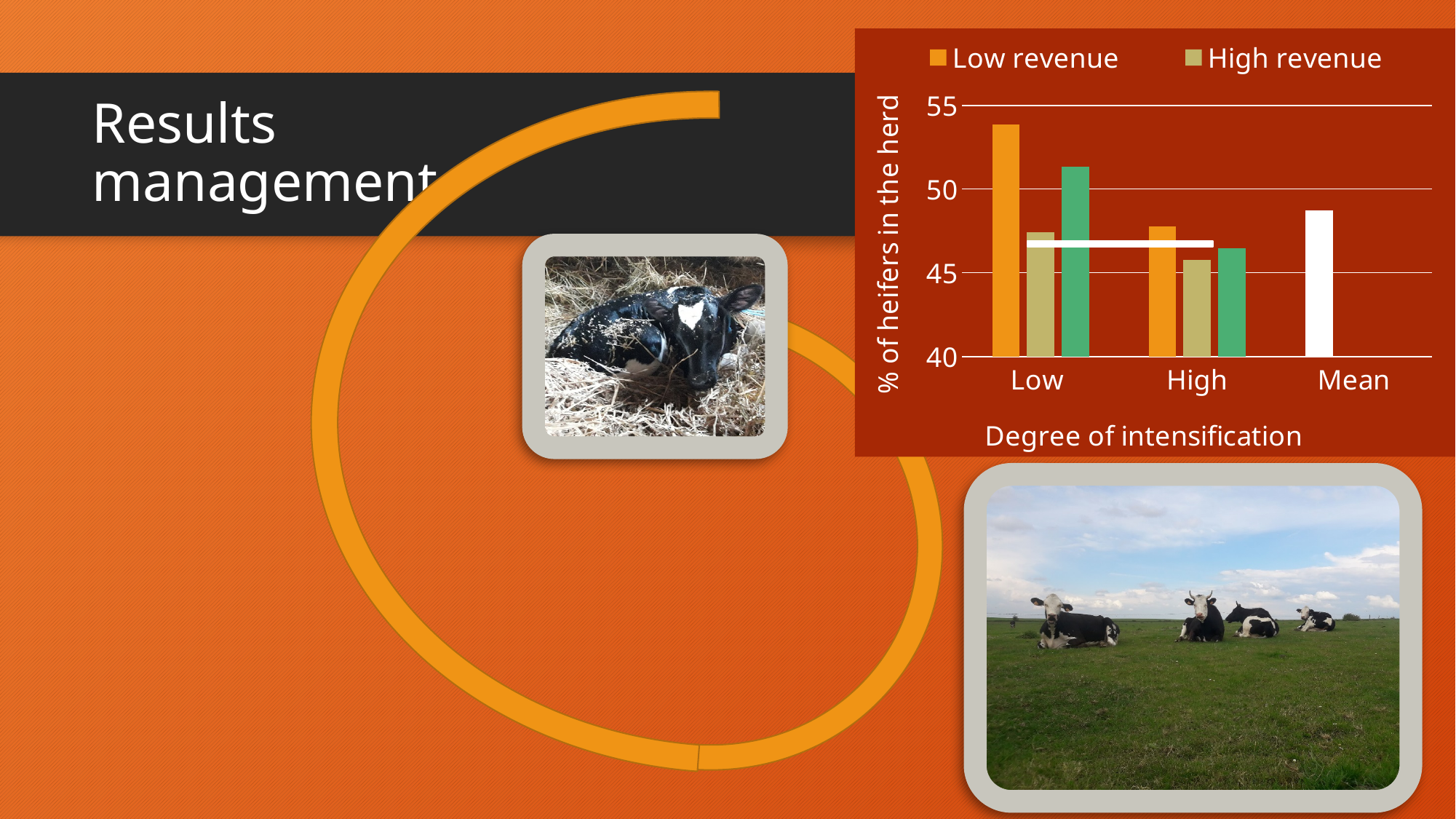
What is the title of the x axis of the chart? Degree of intensification Is the Mean bar greater or less than 45? greater For the Low degree of intensification, which series has the larger value: Low revenue or High revenue? Low revenue What is the title of the y axis of the chart? % of heifers in the herd How many series does the chart legend list? 2 What kind of chart is shown on the slide? bar chart Is the Low revenue value for the Low degree of intensification greater or less than 50? greater Is the High revenue value for the High degree of intensification greater or less than 50? less How many categories are shown on the x axis of the chart? 3 Which is larger for Low revenue: the Low or the High degree of intensification? Low